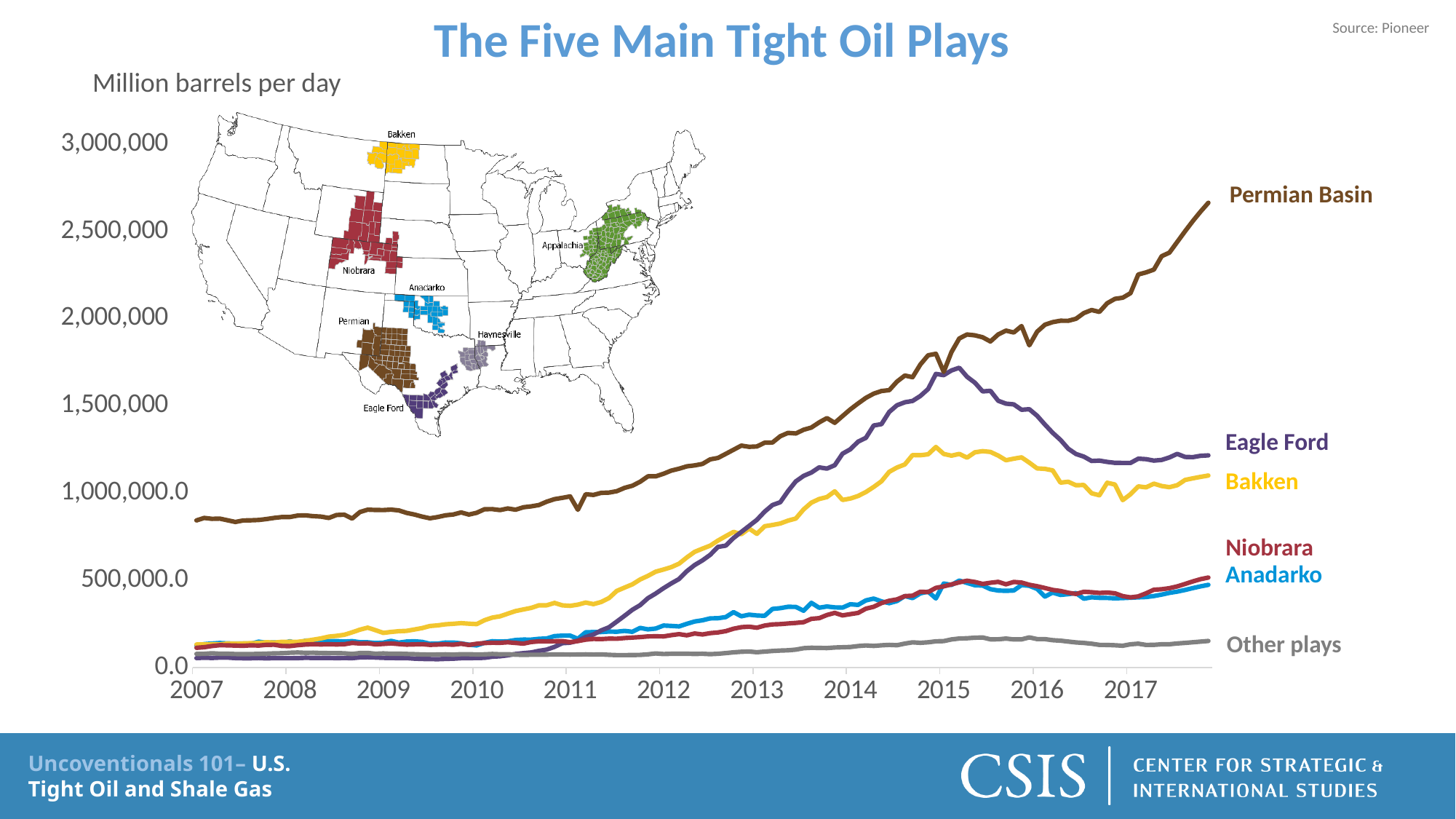
Is the Permian Basin value at the end of 2017 greater or less than 2,500,000? greater Which is larger at the end of the chart, Bakken or Niobrara? Bakken How many series are labelled on the chart? 6 What kind of chart is shown on the slide? line chart Does Permian Basin production rise or fall overall from 2007 to 2017? rise Does Eagle Ford production rise or fall between 2015 and 2016? fall Which series has the lowest production at the end of the chart? Other plays Which play has the highest production at the end of the chart (late 2017)? Permian Basin Is the Eagle Ford peak value in 2015 greater or less than 1,500,000? greater What unit is given for the y axis of the chart? Million barrels per day Is the Permian Basin value in 2007 greater or less than 1,000,000? less